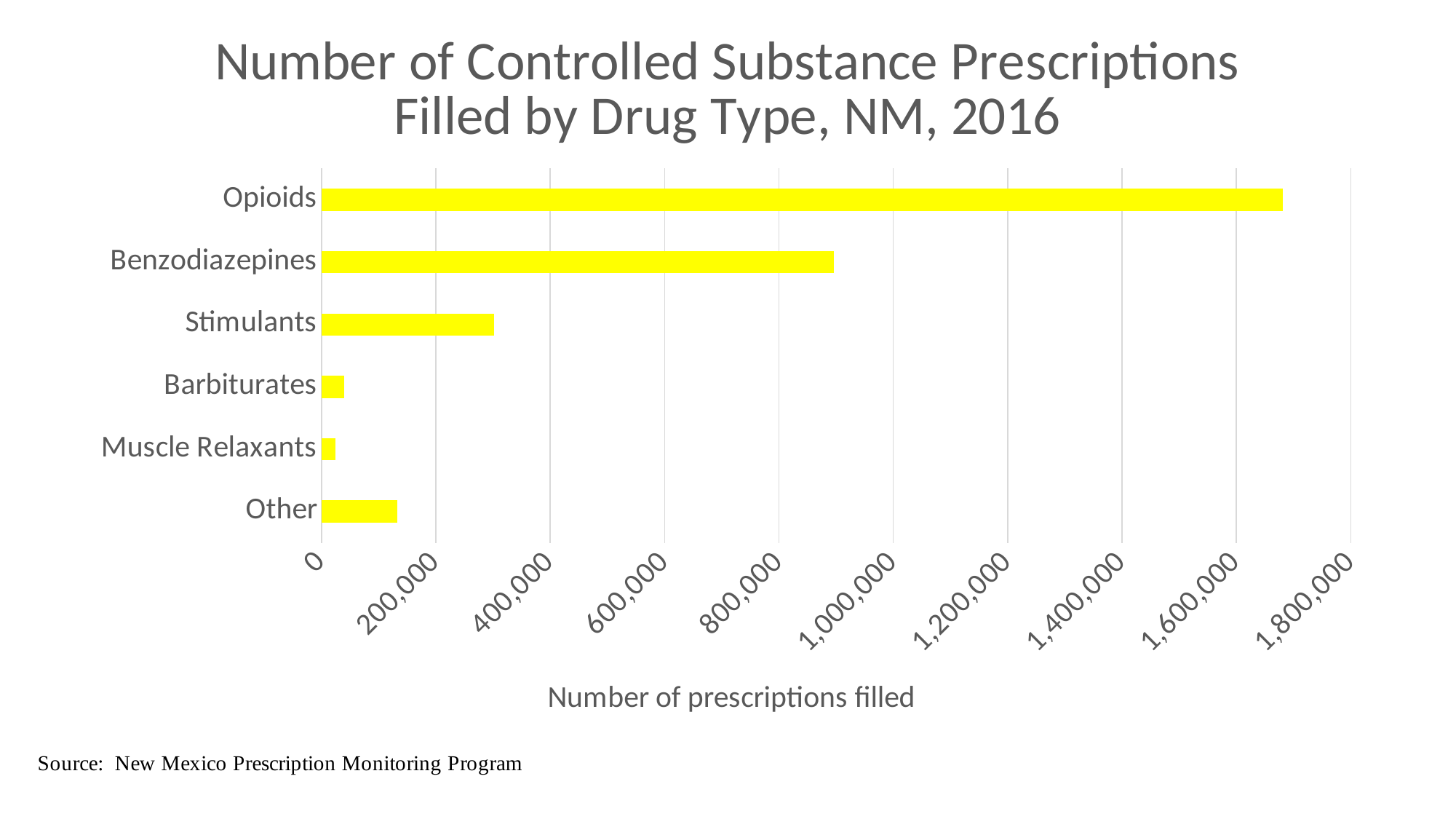
Is the value for Stimulants greater or less than 200,000? greater Which has more prescriptions filled, Other or Barbiturates? Other What is the label of the horizontal axis? Number of prescriptions filled What is the title of the chart? Number of Controlled Substance Prescriptions Filled by Drug Type, NM, 2016 Is the value for Other greater or less than 200,000? less Which has more prescriptions filled, Benzodiazepines or Stimulants? Benzodiazepines Is the value for Benzodiazepines greater or less than 1,000,000? less Which drug type has the lowest number of prescriptions filled? Muscle Relaxants How many drug type categories are shown in the chart? 6 Which drug type has the highest number of prescriptions filled? Opioids What kind of chart is shown on the slide? bar chart